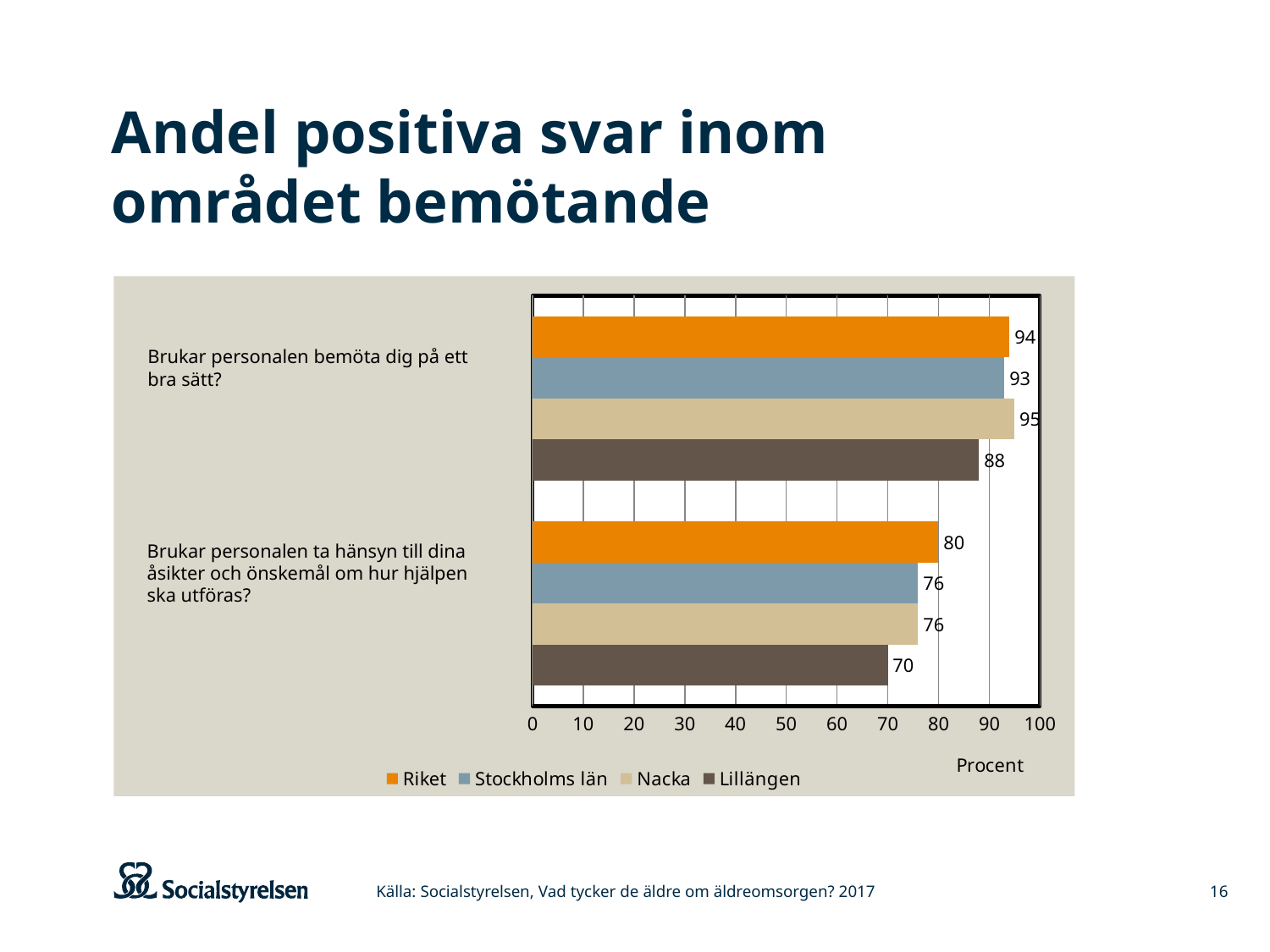
Which is larger for the question 'Brukar personalen ta hänsyn till dina åsikter och önskemål om hur hjälpen ska utföras?': the value for Riket or the value for Nacka? Riket Which series has the highest value for the question 'Brukar personalen bemöta dig på ett bra sätt?' Nacka How many questions (categories) are shown on the chart? 2 Which series has the lowest value for the question 'Brukar personalen ta hänsyn till dina åsikter och önskemål om hur hjälpen ska utföras?' Lillängen What is the difference between the Riket value and the Lillängen value for the question 'Brukar personalen bemöta dig på ett bra sätt?' 6 What kind of chart is shown on the slide? bar chart What is the value for Stockholms län for the question 'Brukar personalen ta hänsyn till dina åsikter och önskemål om hur hjälpen ska utföras?' 76 What is the value for Nacka for the question 'Brukar personalen bemöta dig på ett bra sätt?' 95 What is the value for Lillängen for the question 'Brukar personalen ta hänsyn till dina åsikter och önskemål om hur hjälpen ska utföras?' 70 How many series does the legend list? 4 What is the label on the horizontal axis of the chart? Procent What is the value for Riket for the question 'Brukar personalen bemöta dig på ett bra sätt?' 94